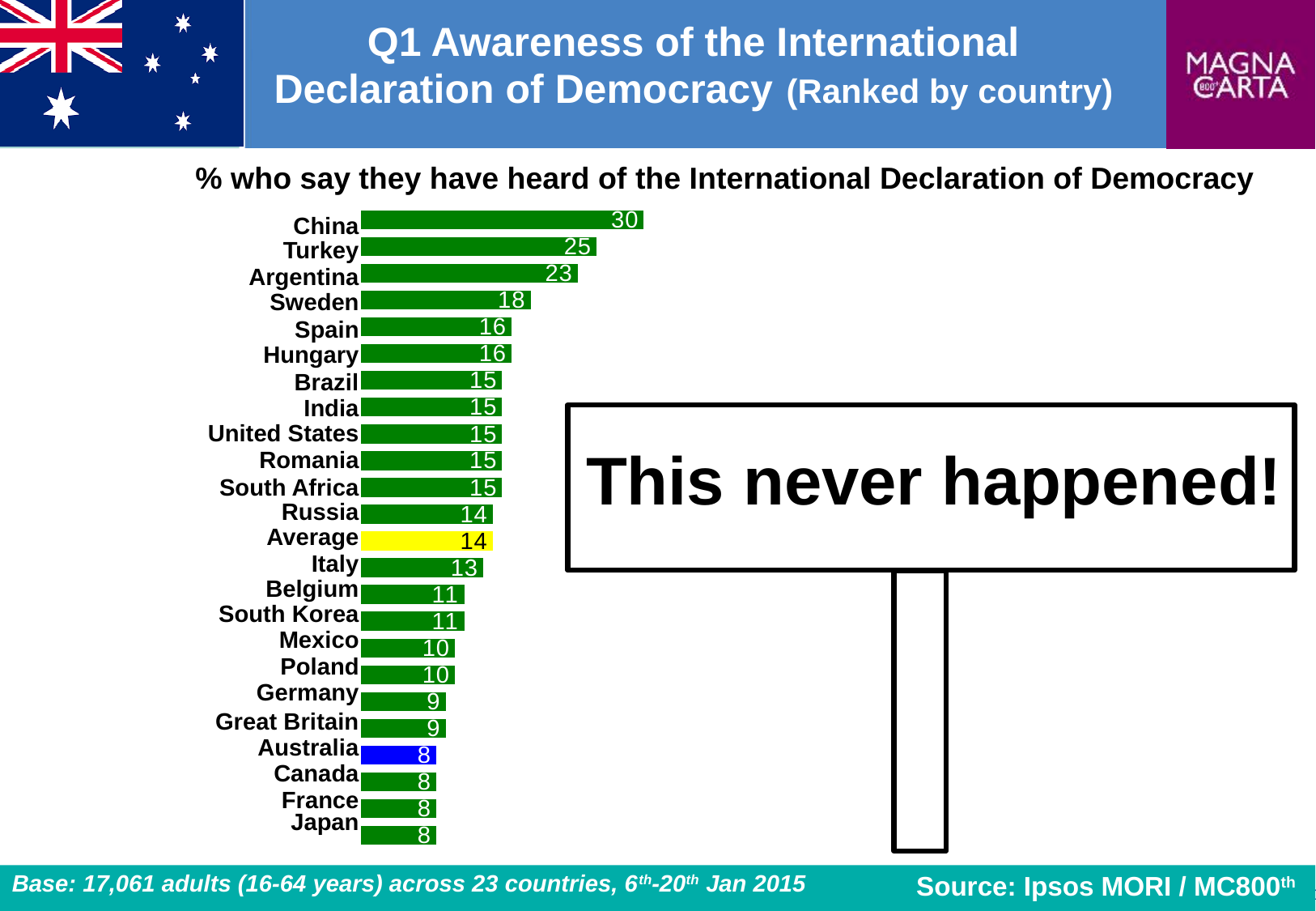
Which has a larger value, Sweden or Italy? Sweden What is the difference between the values for Argentina and Australia? 15 What is the difference between the values for China and Turkey? 5 What is the value for China? 30 Which has a larger value, Russia or Turkey? Turkey What is the value shown for Average? 14 What kind of chart is shown on the slide? Bar chart Which country has the highest value? China Which bar is coloured blue in the chart? Australia What is the value for Sweden? 18 How many bars are plotted in the chart, including the Average bar? 24 What is the value for Australia? 8